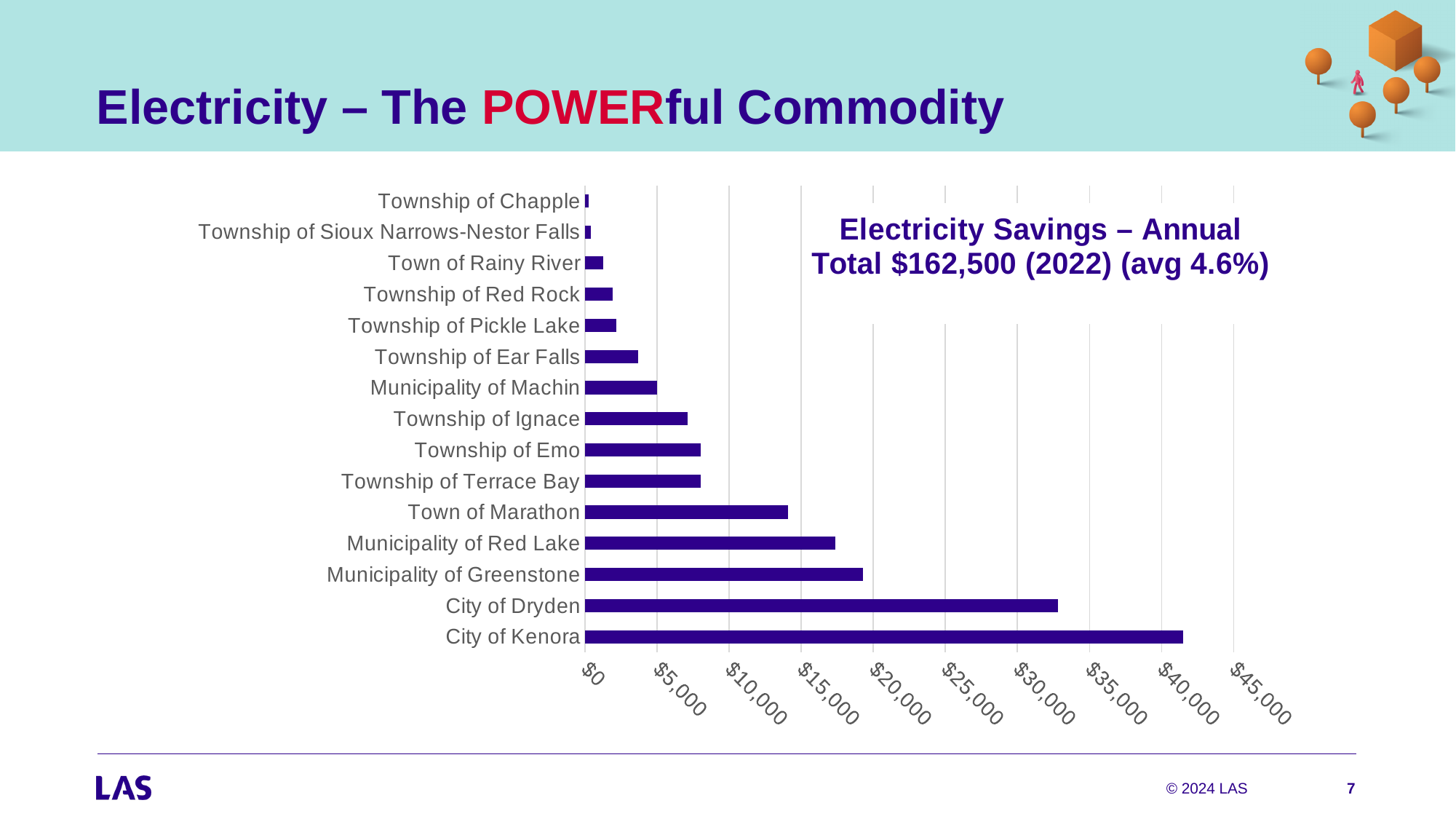
Is the value for Township of Ear Falls greater or less than $5,000? less Which municipality has the highest electricity savings in the chart? City of Kenora Which has the larger electricity savings, Municipality of Red Lake or Town of Marathon? Municipality of Red Lake Is the value for City of Kenora greater or less than $40,000? greater Which has the larger electricity savings, City of Dryden or Municipality of Greenstone? City of Dryden How many municipalities are listed in the chart? 15 Is the value for City of Dryden greater or less than $30,000? greater According to the chart's title text, what is the total annual electricity savings for 2022? $162,500 What kind of chart is shown on the slide? bar chart